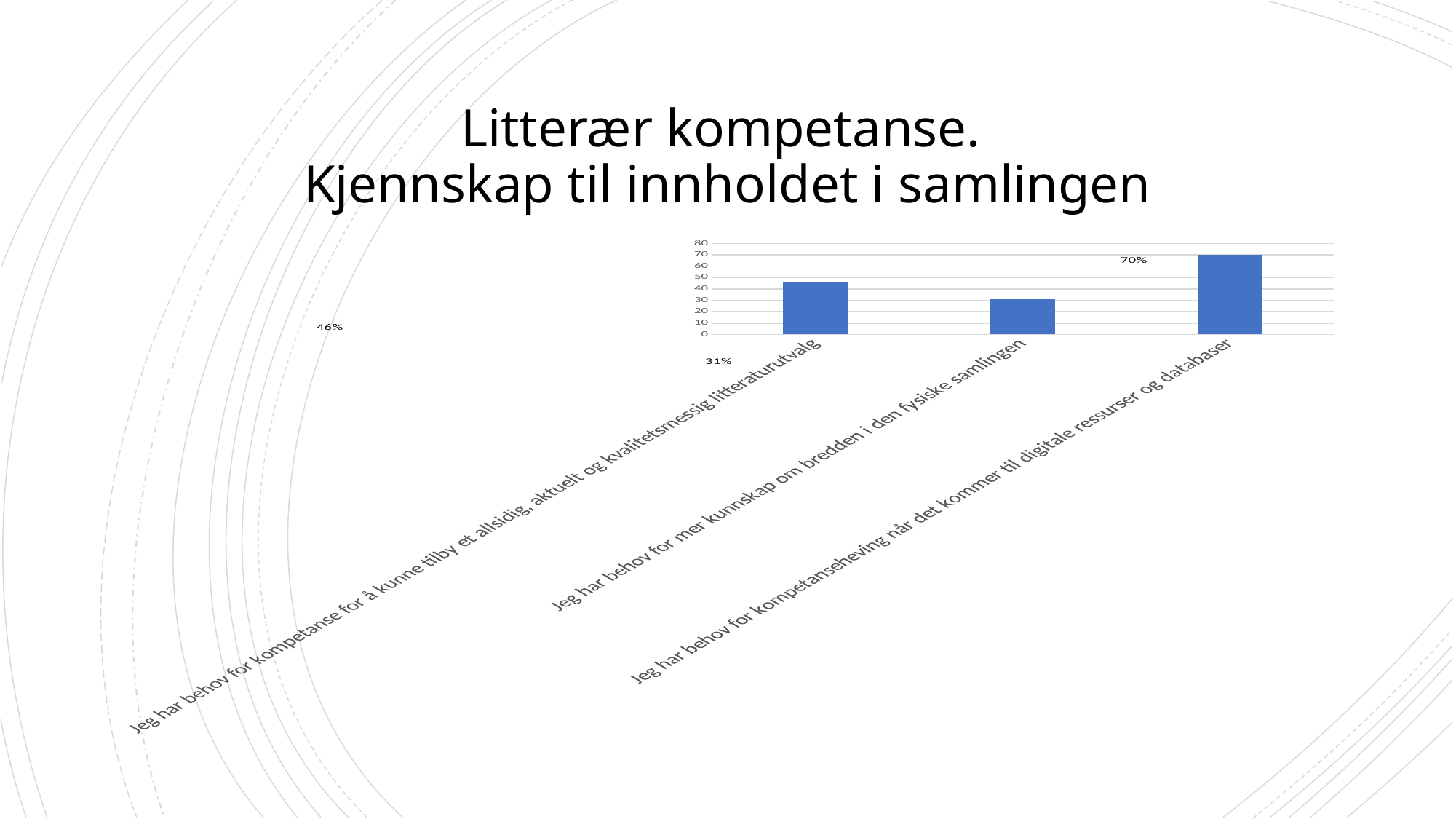
Which category has the highest bar? Jeg har behov for kompetanseheving når det kommer til digitale ressurser og databaser What value is labelled for 'Jeg har behov for mer kunnskap om bredden i den fysiske samlingen'? 31% Which category has the lowest bar? Jeg har behov for mer kunnskap om bredden i den fysiske samlingen How many bars (categories) does the chart show? 3 What is the title of the slide containing the chart? Litterær kompetanse. Kjennskap til innholdet i samlingen What is the highest value shown on the vertical axis? 80 What kind of chart is shown on the slide? bar chart Which is larger: the value for 'Jeg har behov for kompetanse for å kunne tilby et allsidig, aktuelt og kvalitetsmessig litteraturutvalg' or for 'Jeg har behov for mer kunnskap om bredden i den fysiske samlingen'? Jeg har behov for kompetanse for å kunne tilby et allsidig, aktuelt og kvalitetsmessig litteraturutvalg What value is labelled for 'Jeg har behov for kompetanseheving når det kommer til digitale ressurser og databaser'? 70% Is the value for 'Jeg har behov for mer kunnskap om bredden i den fysiske samlingen' greater or less than 40? less What value is labelled for 'Jeg har behov for kompetanse for å kunne tilby et allsidig, aktuelt og kvalitetsmessig litteraturutvalg'? 46% Is the value for 'Jeg har behov for kompetanseheving når det kommer til digitale ressurser og databaser' greater or less than 60? greater